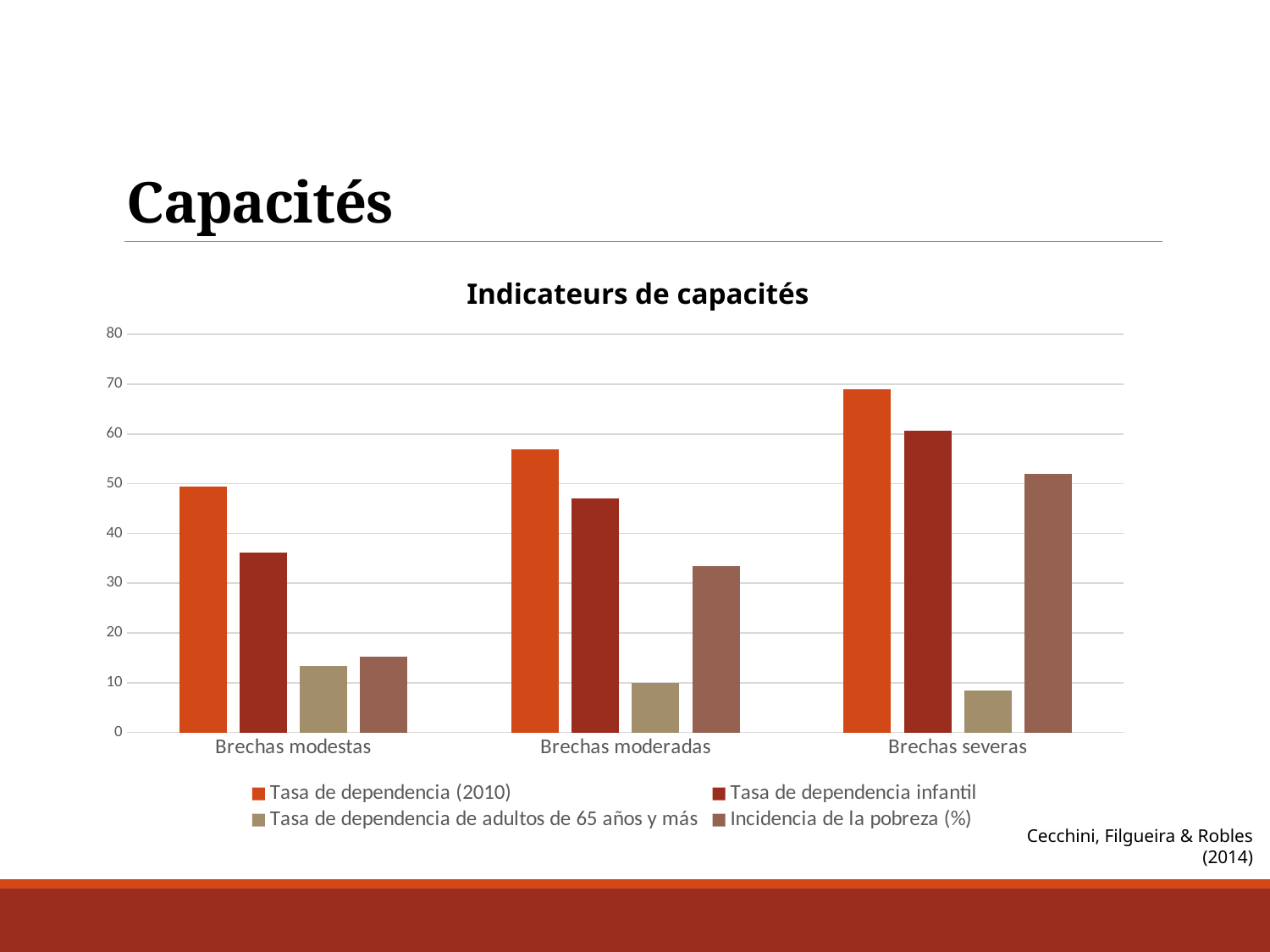
What is the title of the chart on the slide? Indicateurs de capacités How many categories are shown on the x axis of the "Indicateurs de capacités" chart? 3 Which category has the lowest value for "Tasa de dependencia de adultos de 65 años y más"? Brechas severas Is the value of "Incidencia de la pobreza (%)" for Brechas modestas greater or less than 20? less Which is larger for Brechas moderadas: "Tasa de dependencia infantil" or "Incidencia de la pobreza (%)"? Tasa de dependencia infantil Is the value of "Tasa de dependencia (2010)" for Brechas severas greater or less than 60? greater Does the value of "Tasa de dependencia de adultos de 65 años y más" rise or fall from Brechas modestas to Brechas severas? fall Which category has the highest value for "Tasa de dependencia (2010)"? Brechas severas How many series does the legend of the "Indicateurs de capacités" chart list? 4 Is the value of "Tasa de dependencia infantil" for Brechas moderadas greater or less than 40? greater Does the value of "Incidencia de la pobreza (%)" rise or fall from Brechas modestas to Brechas severas? rise What kind of chart is shown under the title "Indicateurs de capacités"? bar chart